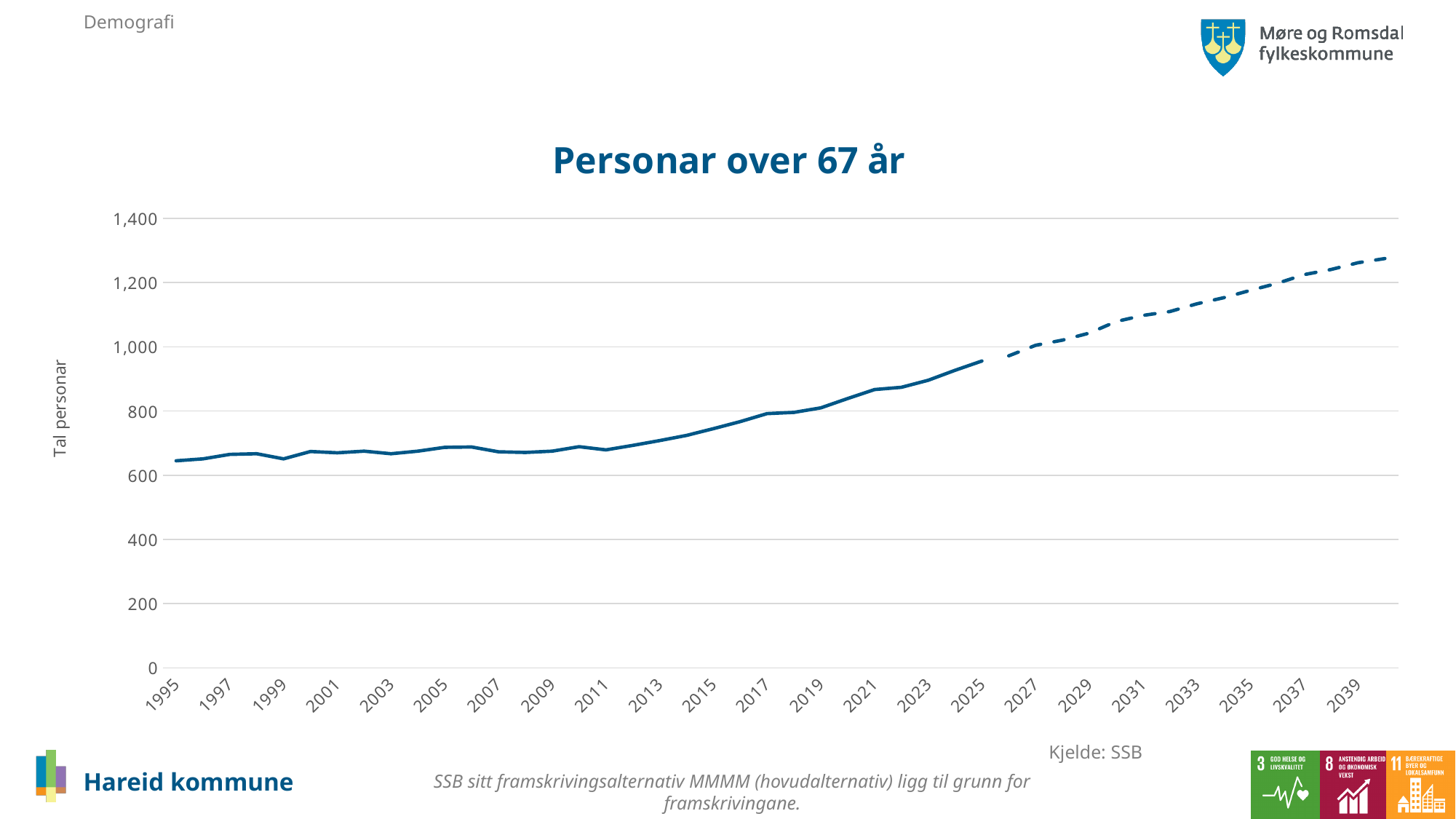
Is the value for 2039 greater or less than 1,200? greater What is the label on the vertical axis of the chart? Tal personar Is the value for 1995 greater or less than 800? less Is the value for 2011 greater or less than 600? greater What is the title of the chart? Personar over 67 år Do the values generally rise or fall from 1995 to the end of the series? rise What kind of chart is shown on the slide? line chart Which year has the larger value, 2005 or 2025? 2025 Which year has the larger value, 2013 or 2033? 2033